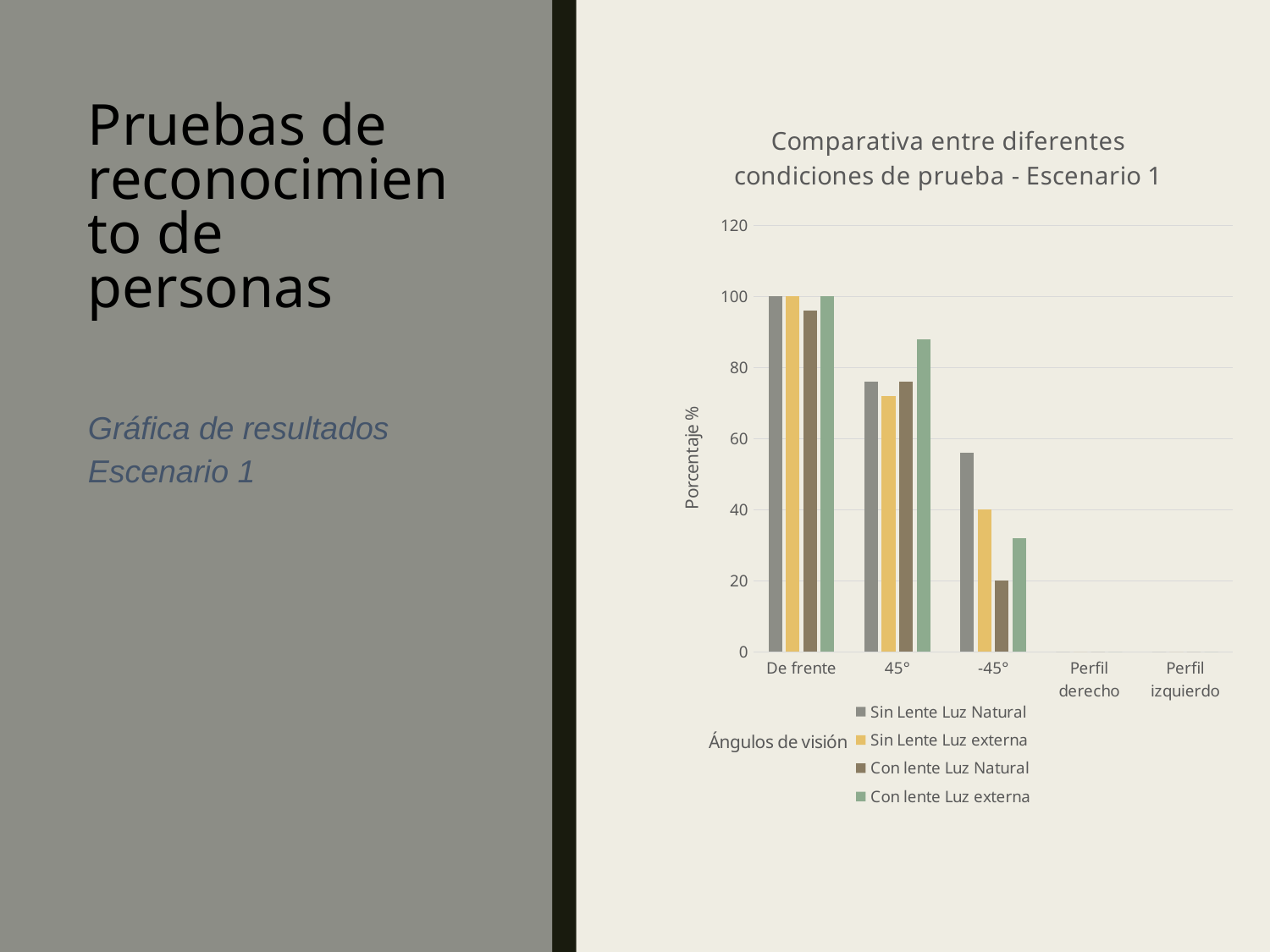
What is the title of the vertical axis of the chart? Porcentaje % What type of chart is shown on the slide? Bar chart How many series does the legend of the chart list? 4 Is the value for Sin Lente Luz Natural at -45° greater or less than 40? greater What is the value for Sin Lente Luz externa at -45°? 40 How many categories are shown on the x axis of the chart? 5 At 45°, which is larger: Con lente Luz externa or Sin Lente Luz externa? Con lente Luz externa Which series has the lowest value at -45°? Con lente Luz Natural What is the value for Sin Lente Luz Natural at De frente? 100 Is the value for Con lente Luz externa at 45° greater or less than 80? greater Which series has the highest value at -45°? Sin Lente Luz Natural What is the value for Con lente Luz Natural at -45°? 20